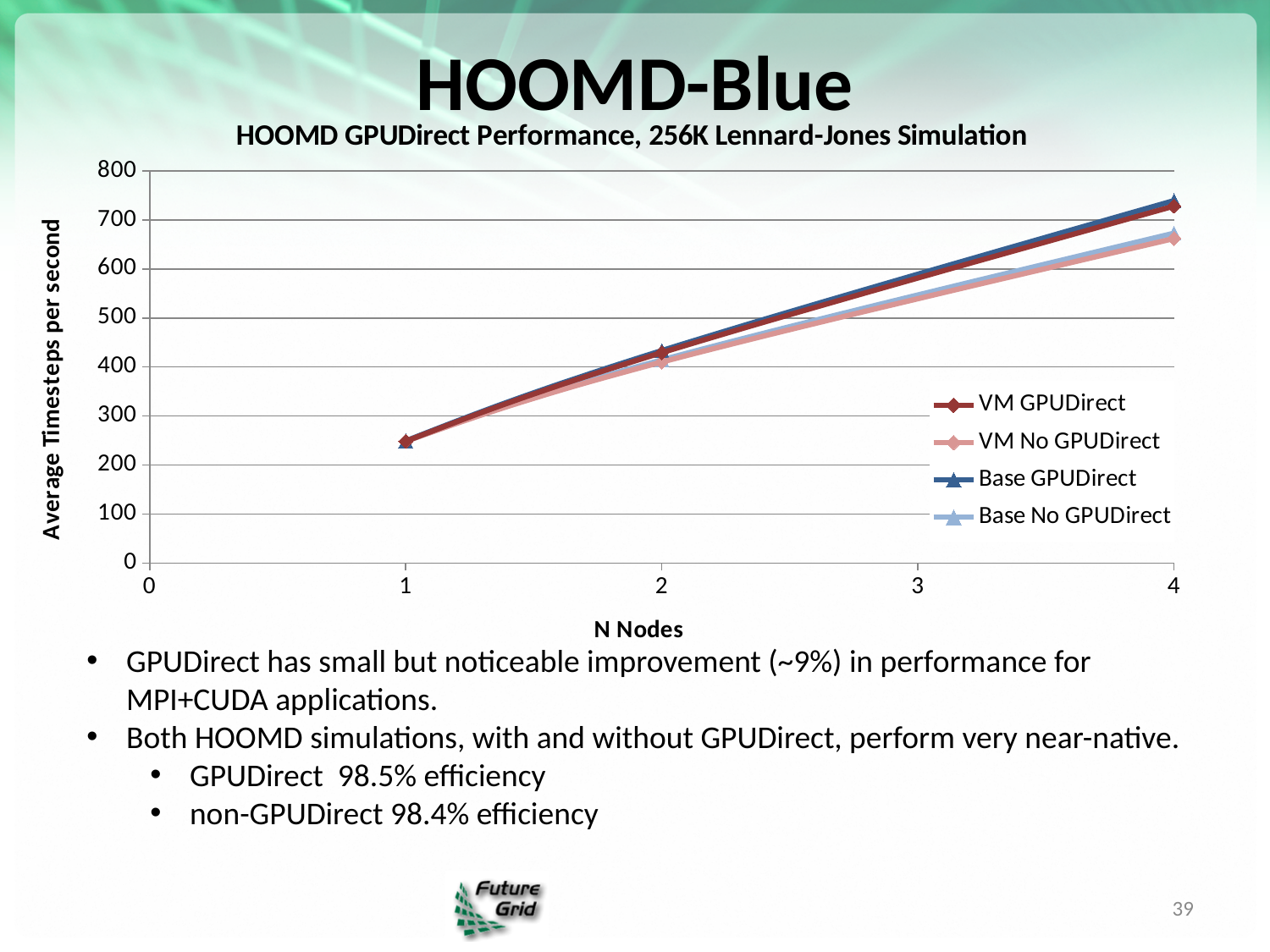
Do the values for Base GPUDirect rise or fall as N Nodes increases? rise How many series does the chart legend list? 4 At 4 nodes, which is larger: Base GPUDirect or Base No GPUDirect? Base GPUDirect What is the title of the chart? HOOMD GPUDirect Performance, 256K Lennard-Jones Simulation How many data points are plotted for the VM GPUDirect series? 3 Is the value for Base GPUDirect at 1 node greater or less than 300? less What is the label of the y axis? Average Timesteps per second Is the value for Base No GPUDirect at 4 nodes greater or less than 700? less What kind of chart is shown on the slide? line chart Is the value for VM GPUDirect at 4 nodes greater or less than 700? greater At 4 nodes, which is larger: VM GPUDirect or VM No GPUDirect? VM GPUDirect